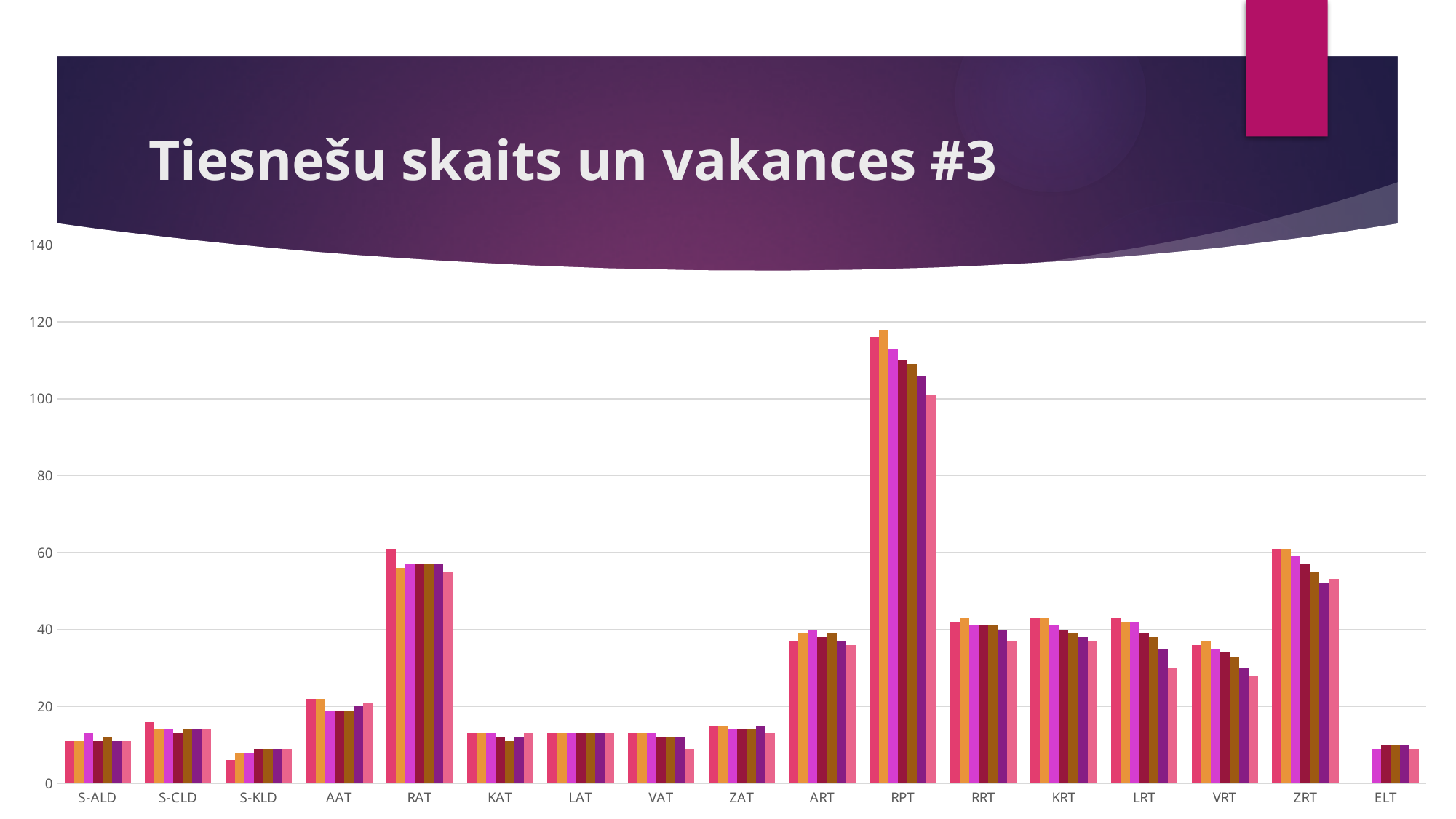
Are the values for RPT greater or less than 100? greater What is the title of the slide containing the chart? Tiesnešu skaits un vakances #3 What kind of chart is shown on the slide? bar chart Which category has larger values, RAT or KAT? RAT Are the values for ELT greater or less than 20? less Which category has larger values, ZRT or VRT? ZRT Which category has the tallest bars in the chart? RPT What is the highest value shown on the vertical axis of the chart? 140 Are the values for ART greater or less than 60? less How many categories are shown along the x axis of the chart? 17